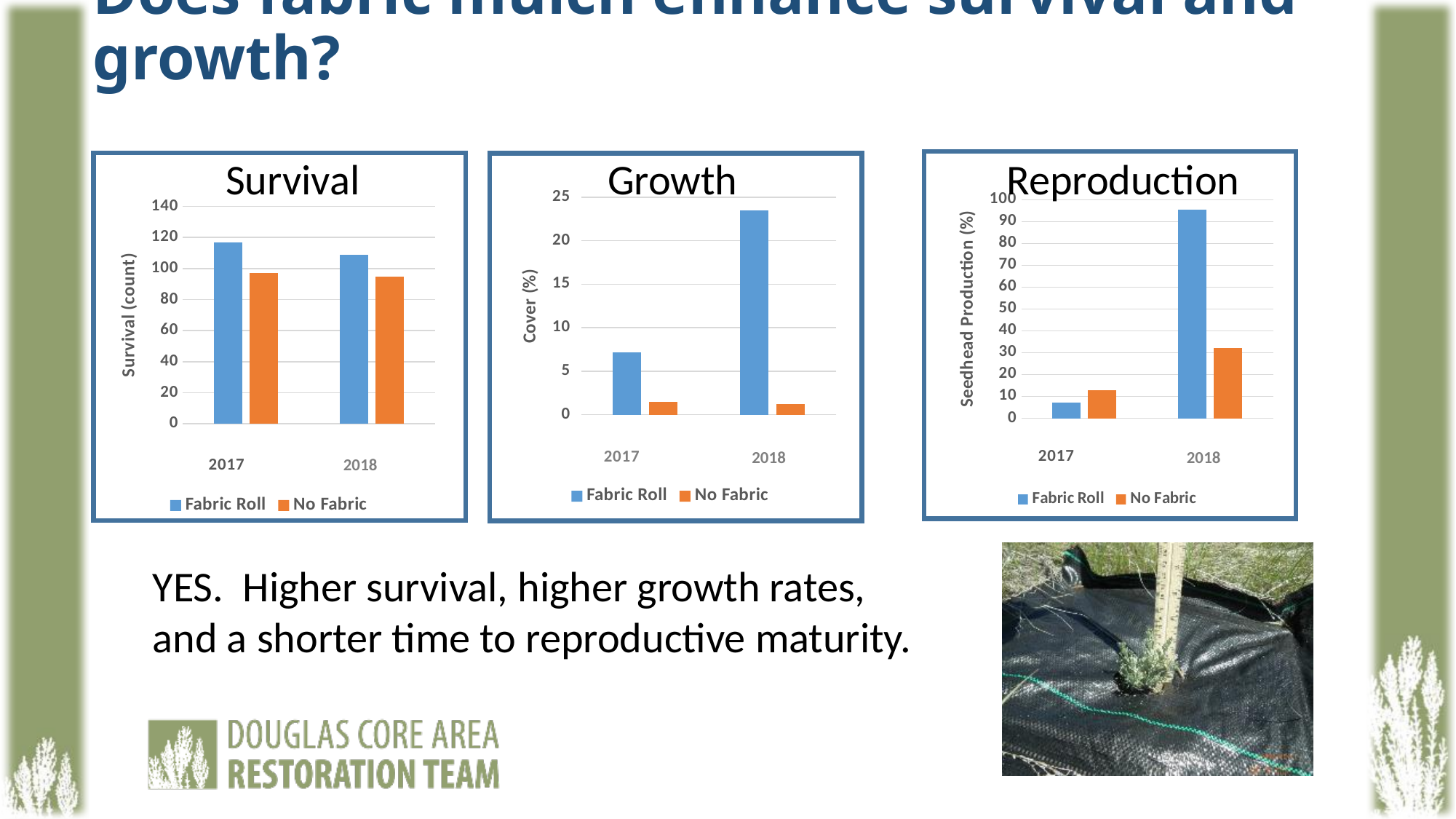
In the Reproduction chart, is the value for Fabric Roll in 2018 greater or less than 90? greater In the Survival chart, what kind of chart is shown? bar chart In the Growth chart, which year has the higher Fabric Roll value? 2018 In the Reproduction chart, in 2017, which series has the larger value, Fabric Roll or No Fabric? No Fabric In the Growth chart, what is the y-axis title? Cover (%) In the Survival chart, is the value for Fabric Roll in 2017 greater or less than 100? greater In the Growth chart, is the value for Fabric Roll in 2017 greater or less than 5? greater In the Survival chart, how many series does the legend list? 2 In the Survival chart, how many years are shown on the x axis? 2